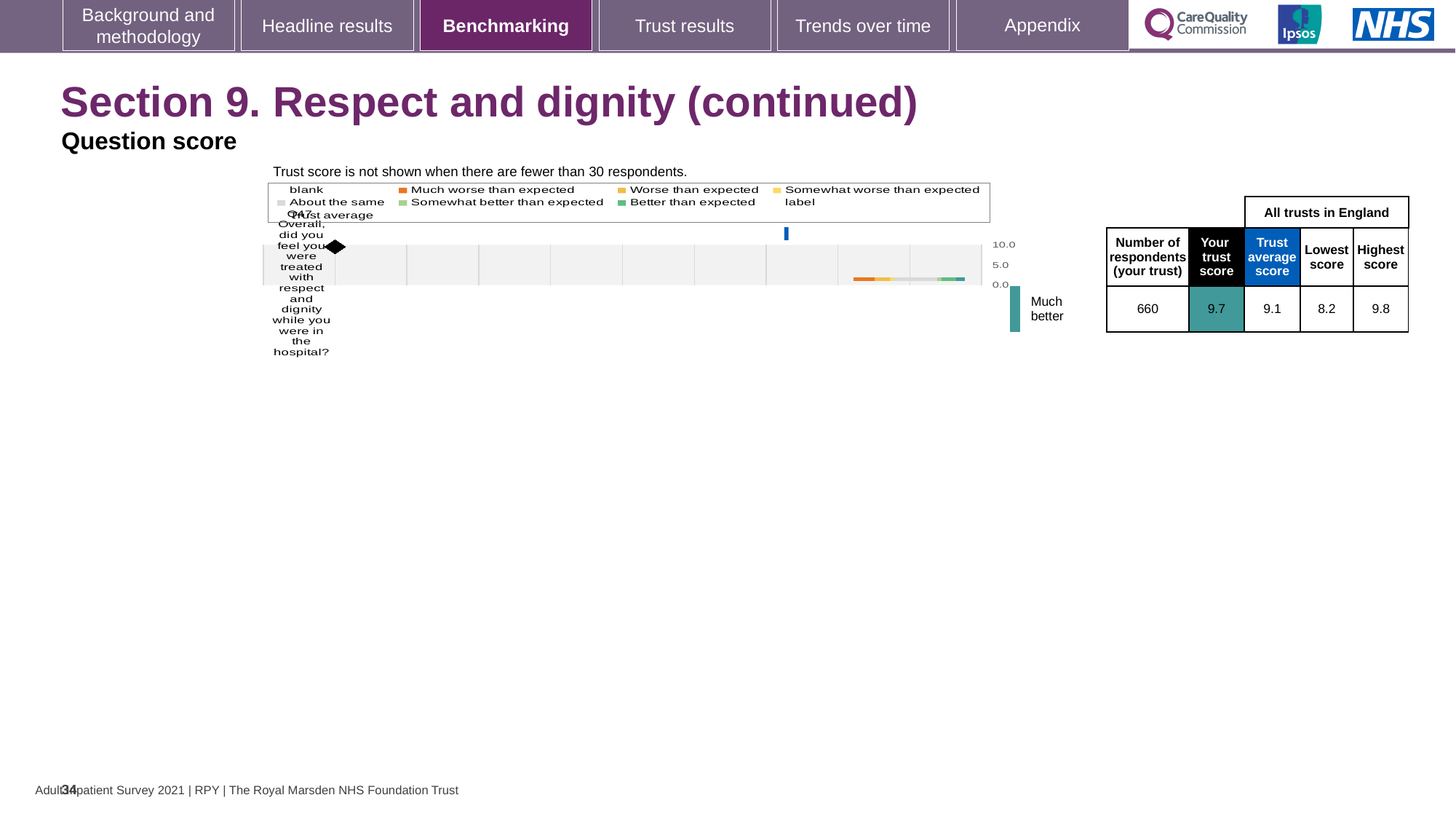
What is the 'Highest score' among all trusts in England? 9.8 What is 'Your trust score' shown in the table? 9.7 What colour does the legend use for 'Much worse than expected'? orange What is the 'Lowest score' among all trusts in England? 8.2 By how much does your trust score exceed the trust average score? 0.6 What kind of chart is shown on the slide? bar chart How many survey questions are plotted on the chart? 1 What is the number of respondents for your trust shown in the table? 660 Which is larger, your trust score or the trust average score? Your trust score What is the highest value shown on the chart's numeric axis? 10.0 What is the difference between the highest score and the lowest score for all trusts in England? 1.6 What is the 'Trust average score' for all trusts in England? 9.1